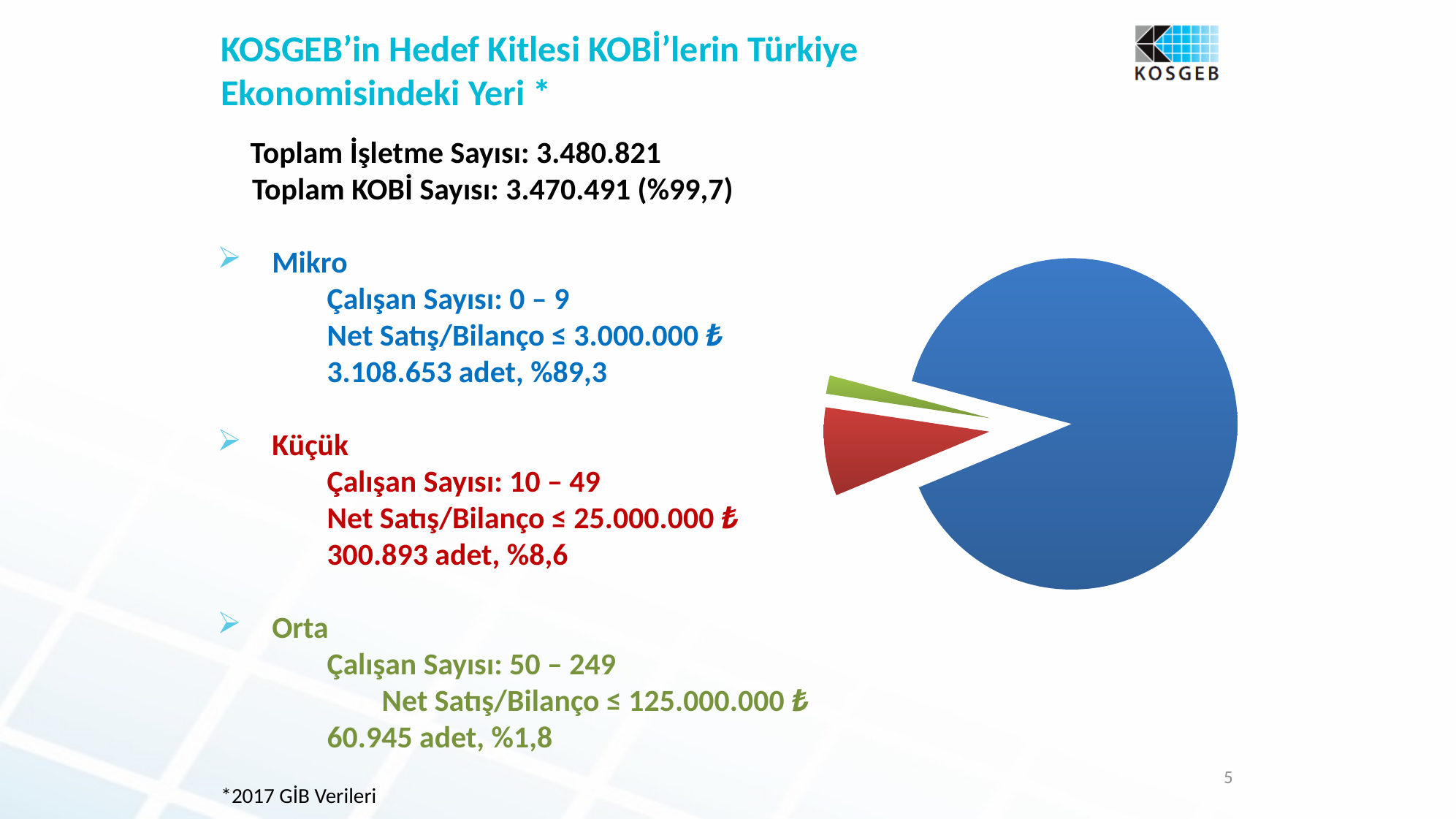
How many slices does the pie chart have? 3 Which slice is larger, Küçük or Orta? Küçük What colour is the slice representing the Mikro category? blue How many enterprises (adet) are in the Küçük category? 300.893 Which category has the smallest slice of the pie chart? Orta How many enterprises (adet) are in the Mikro category? 3.108.653 What share of the pie does the Orta slice represent? %1,8 What share of the pie does the Küçük slice represent? %8,6 What share of the pie does the Mikro slice represent? %89,3 What kind of chart is shown on the slide? pie chart Which category has the largest slice of the pie chart? Mikro How many enterprises (adet) are in the Orta category? 60.945